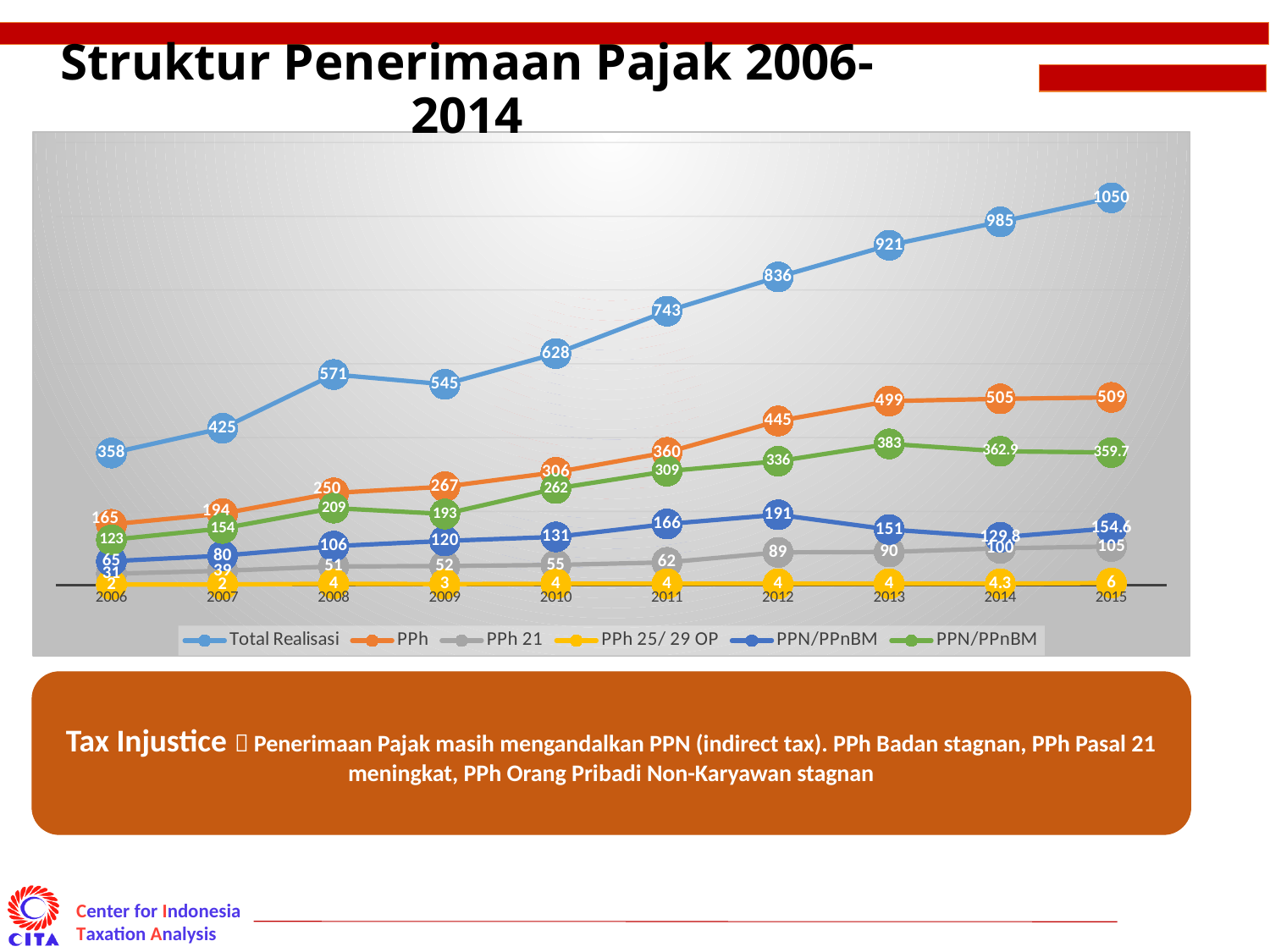
Does Total Realisasi generally rise or fall from 2006 to 2015? rise Which is larger in 2013: PPh or PPh 21? PPh How many years are plotted on the x axis? 10 What is the value of PPh 21 in 2014? 100 What is the difference between Total Realisasi in 2015 and in 2006? 692 What is the value of Total Realisasi in 2015? 1050 What is the value of PPh 25/ 29 OP in 2015? 6 In which year is Total Realisasi highest? 2015 What kind of chart is shown on the slide? line chart In which year is PPh lowest? 2006 How many series does the legend list? 6 What is the value of PPh in 2012? 445